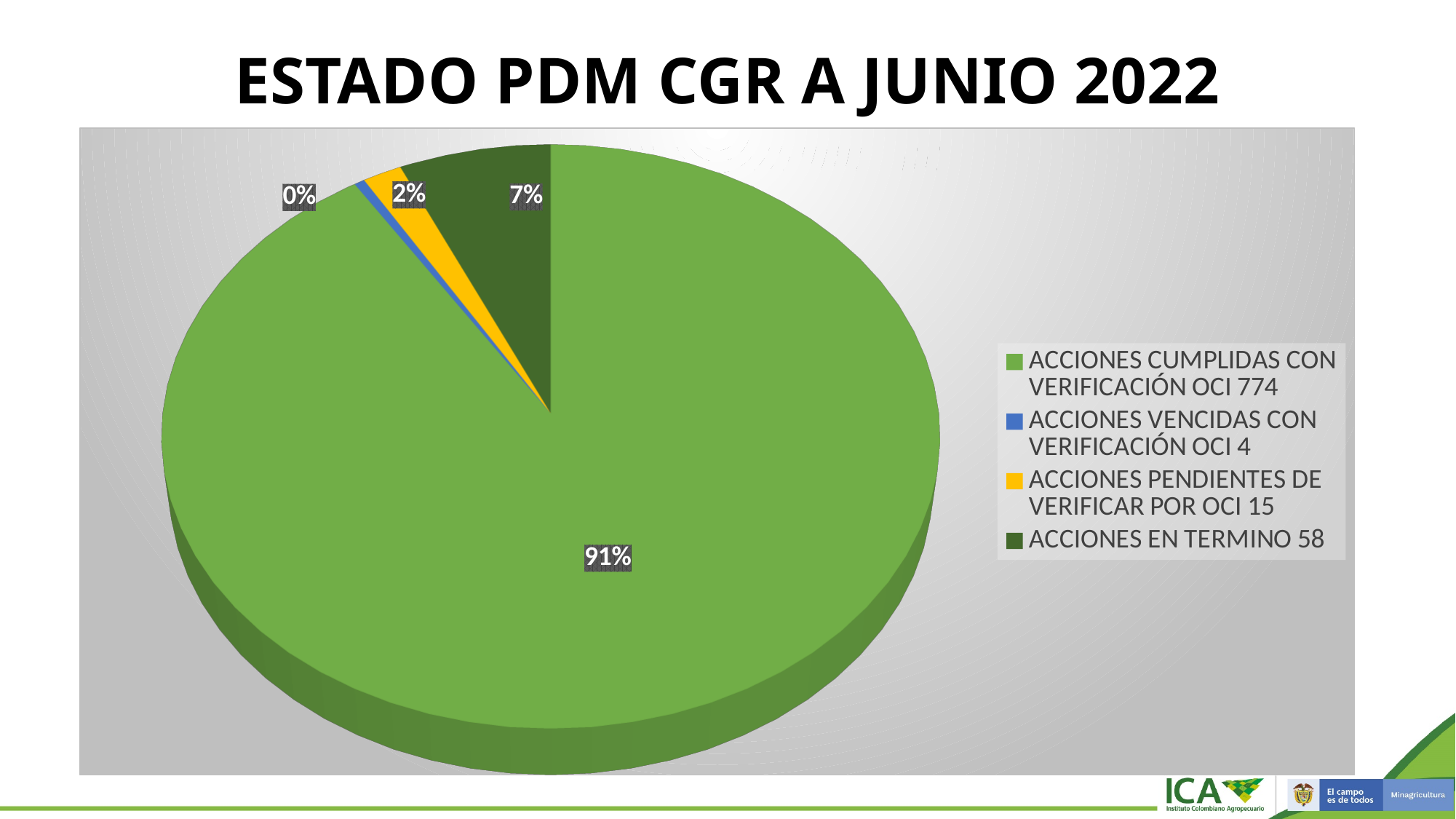
How many entries does the legend list? 4 Which is larger, the share for ACCIONES EN TERMINO or the share for ACCIONES PENDIENTES DE VERIFICAR POR OCI? ACCIONES EN TERMINO What is the title of the slide? ESTADO PDM CGR A JUNIO 2022 How many slices does the pie chart have? 4 What is the difference in percentage points between the share for ACCIONES CUMPLIDAS CON VERIFICACIÓN OCI and the share for ACCIONES EN TERMINO? 84% What kind of chart is shown on the slide? pie chart What percentage share is shown for ACCIONES CUMPLIDAS CON VERIFICACIÓN OCI? 91% What percentage share is shown for ACCIONES PENDIENTES DE VERIFICAR POR OCI? 2% Which category has the largest slice of the pie? ACCIONES CUMPLIDAS CON VERIFICACIÓN OCI What percentage share is shown for ACCIONES EN TERMINO? 7% Which category has the smallest slice of the pie? ACCIONES VENCIDAS CON VERIFICACIÓN OCI